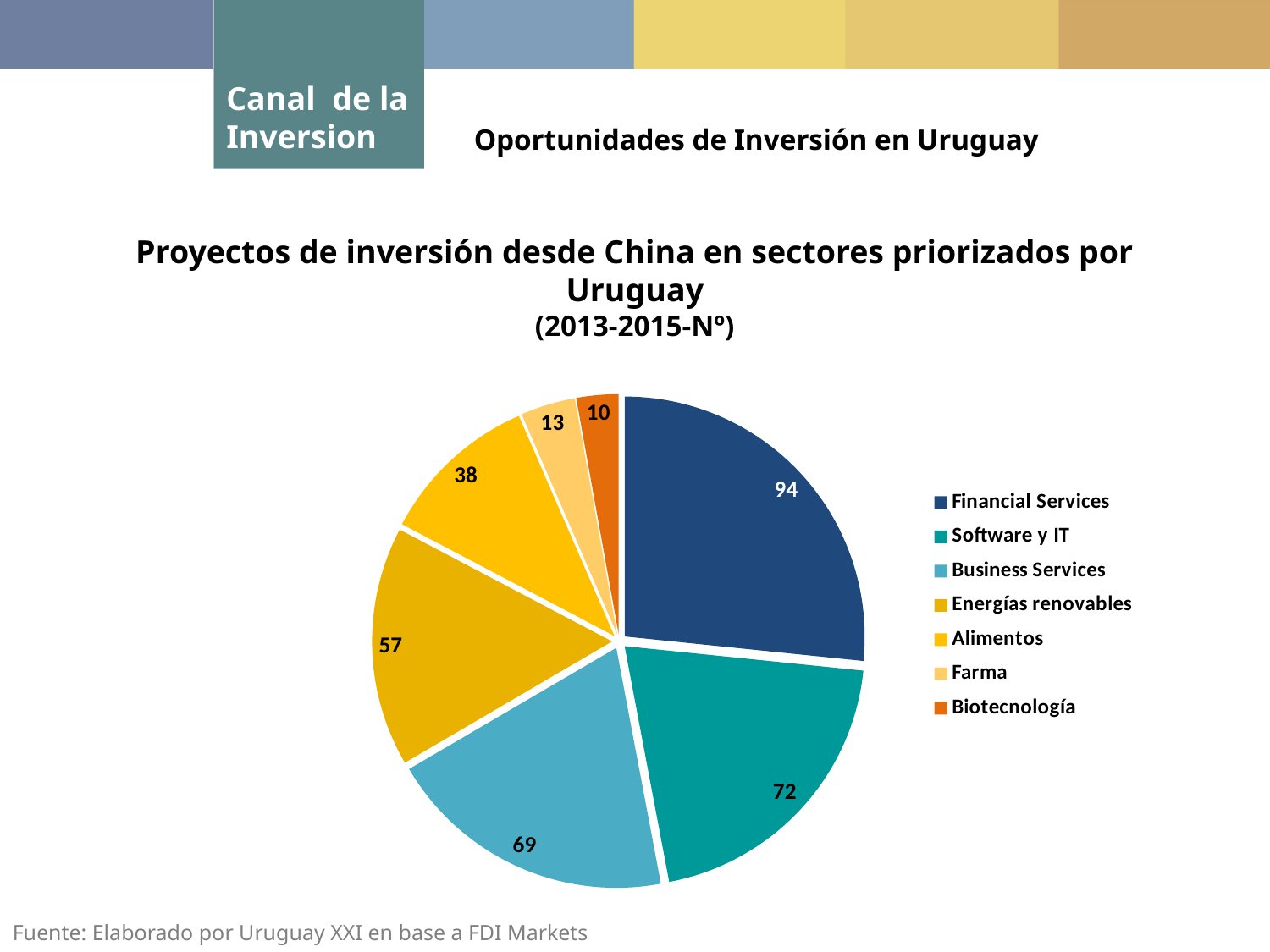
Which sector has the largest slice of the pie? Financial Services What is the difference between the values for Financial Services and Software y IT? 22 Which sector has the smallest slice of the pie? Biotecnología What period does the chart title say the data covers? 2013-2015 What is the value for Energías renovables? 57 What type of chart is shown on the slide? Pie chart How many projects are shown for Financial Services? 94 What is the difference between the values for Alimentos and Farma? 25 What is the value for Farma? 13 How many sectors are shown in the pie chart? 7 Which is larger, the value for Business Services or the value for Alimentos? Business Services What is the total of all the values shown in the pie chart? 353